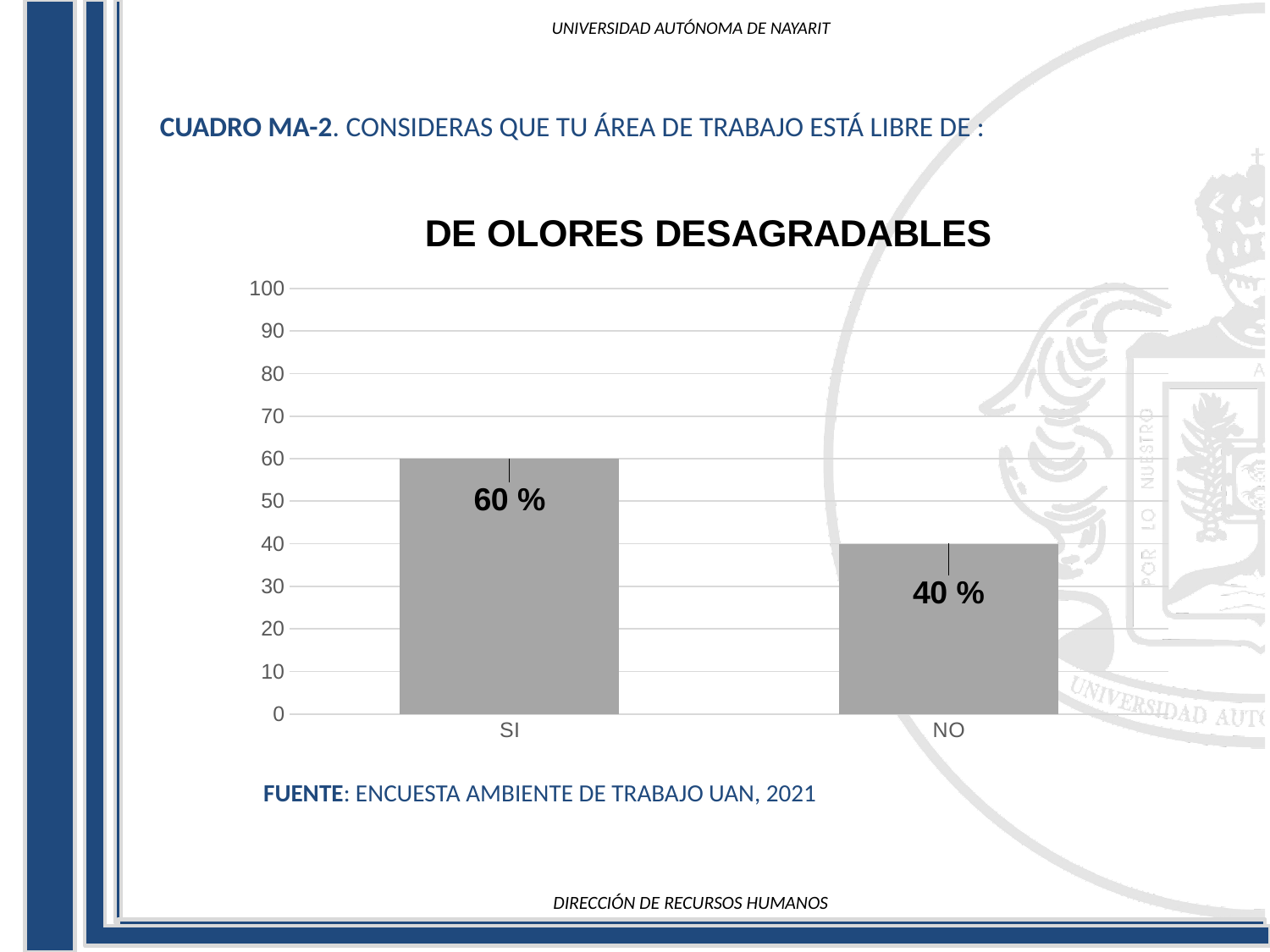
What is the value for SI? 60 % Is the value for NO greater or less than 50? less What is the maximum value shown on the y axis? 100 What is the value for NO? 40 % What is the title of the chart? DE OLORES DESAGRADABLES How many categories are shown on the x axis? 2 What kind of chart is shown? bar chart Which category has the lowest value? NO Which category has the highest value? SI Which is larger, the value for SI or the value for NO? SI Is the value for SI greater or less than 50? greater What is the difference between the values for SI and NO? 20 %